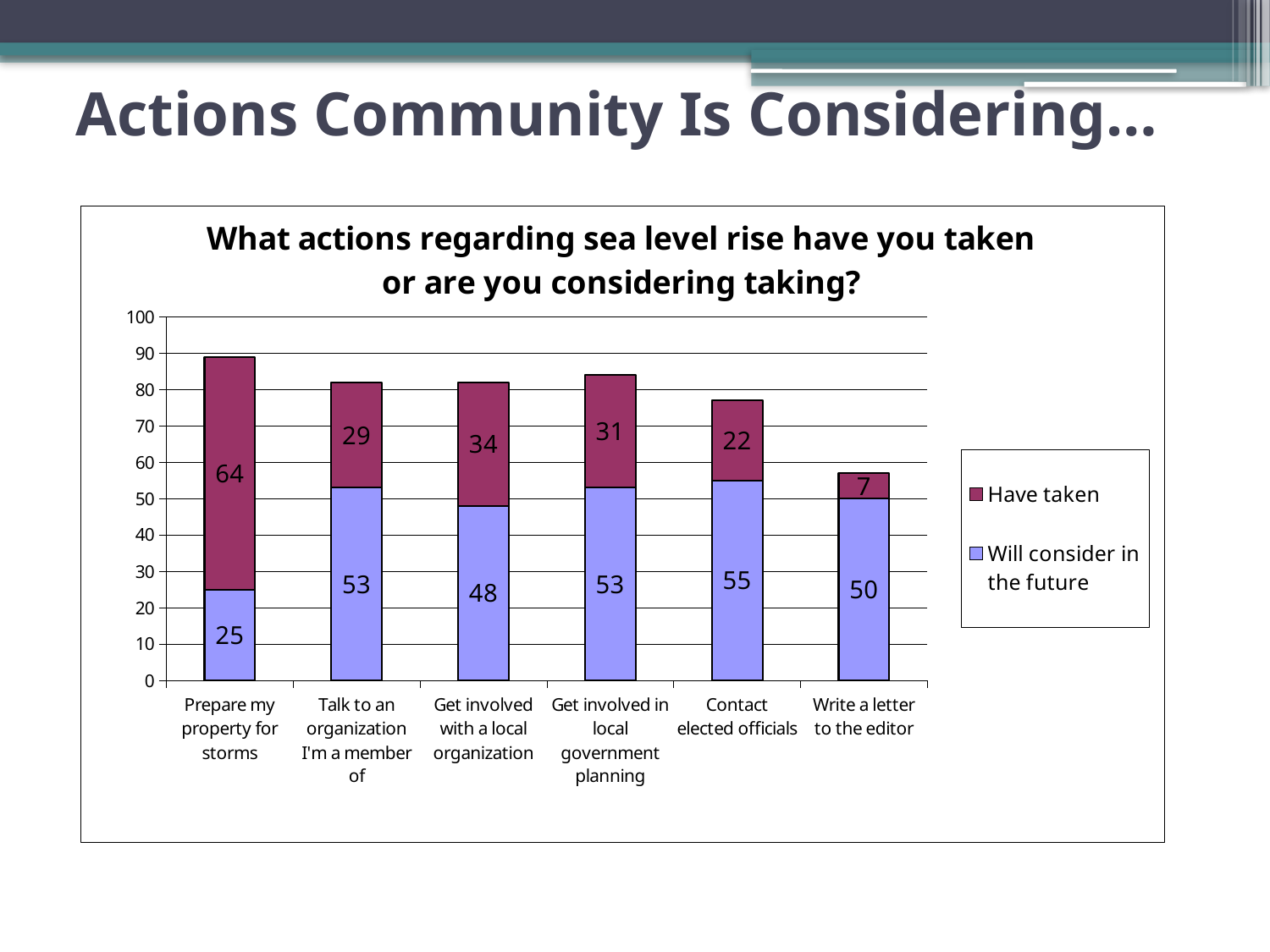
What kind of chart is shown? Stacked bar chart Which category has the highest 'Have taken' value? Prepare my property for storms What is the 'Will consider in the future' value for 'Contact elected officials'? 55 Which is larger: the 'Will consider in the future' value for 'Contact elected officials' or for 'Get involved with a local organization'? Contact elected officials Which category has the lowest 'Will consider in the future' value? Prepare my property for storms How many series does the legend list? 2 What is the total of the stacked bar for 'Get involved in local government planning'? 84 What is the total of the stacked bar for 'Prepare my property for storms'? 89 What is the 'Have taken' value for 'Write a letter to the editor'? 7 What is the 'Have taken' value for 'Prepare my property for storms'? 64 How many categories are shown on the x axis? 6 What is the difference between the 'Have taken' values for 'Get involved with a local organization' and 'Talk to an organization I'm a member of'? 5